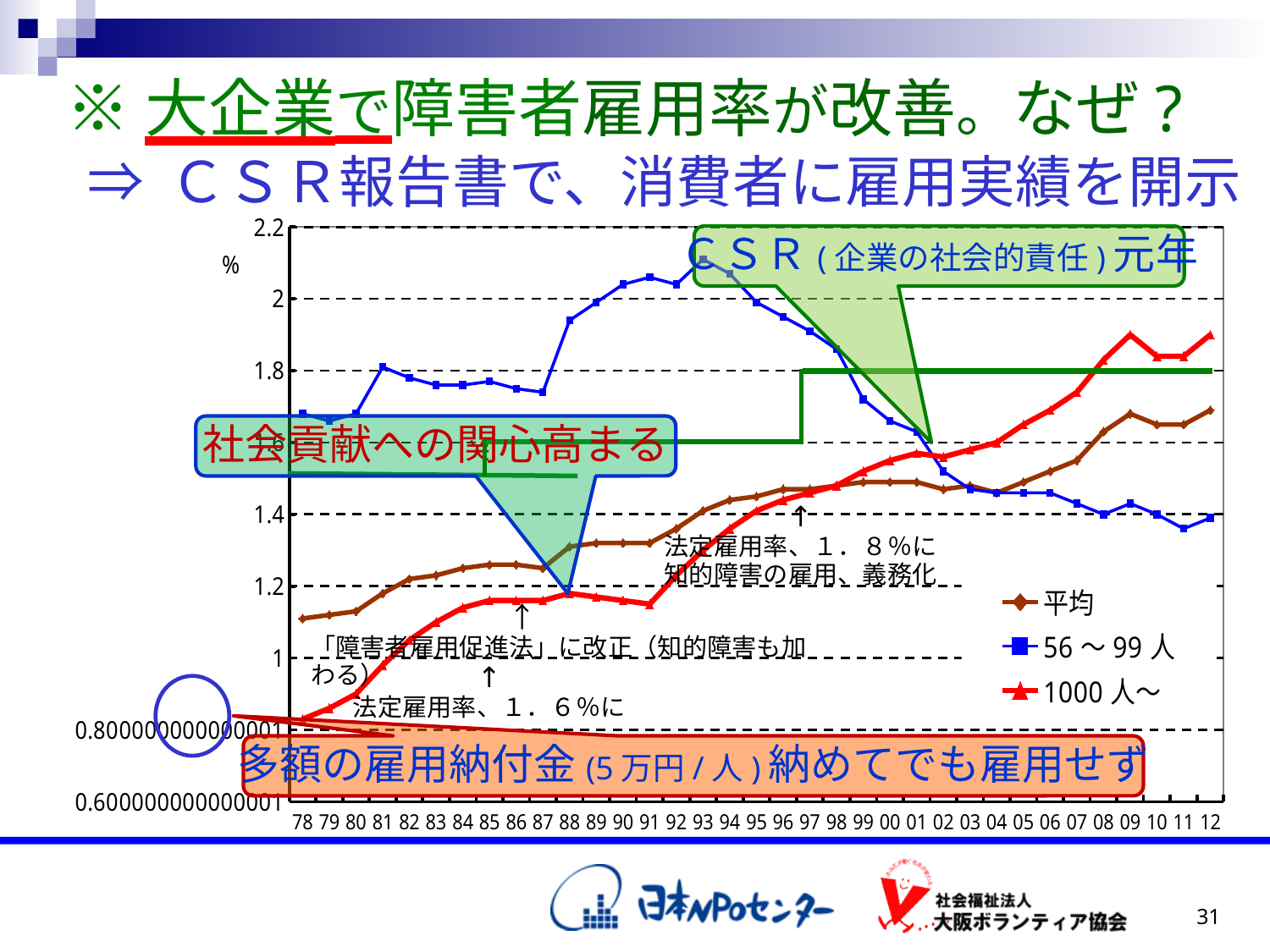
Is the value for 平均 in 78 greater or less than 1? greater What unit is shown on the vertical axis? % In 93, which series has the higher value, 56～99人 or 1000人～? 56～99人 What kind of chart is shown on the slide? line chart Is the value for 1000人～ in 09 greater or less than 1.8? greater Does the 56～99人 series rise or fall from 93 to 12? fall In 12, which of the three series has the highest value? 1000人～ What are the three series named in the legend? 平均, 56～99人, 1000人～ How many years are labelled along the x axis (78 through 12)? 35 Is the value for 56～99人 in 93 greater or less than 2? greater How many series does the legend list? 3